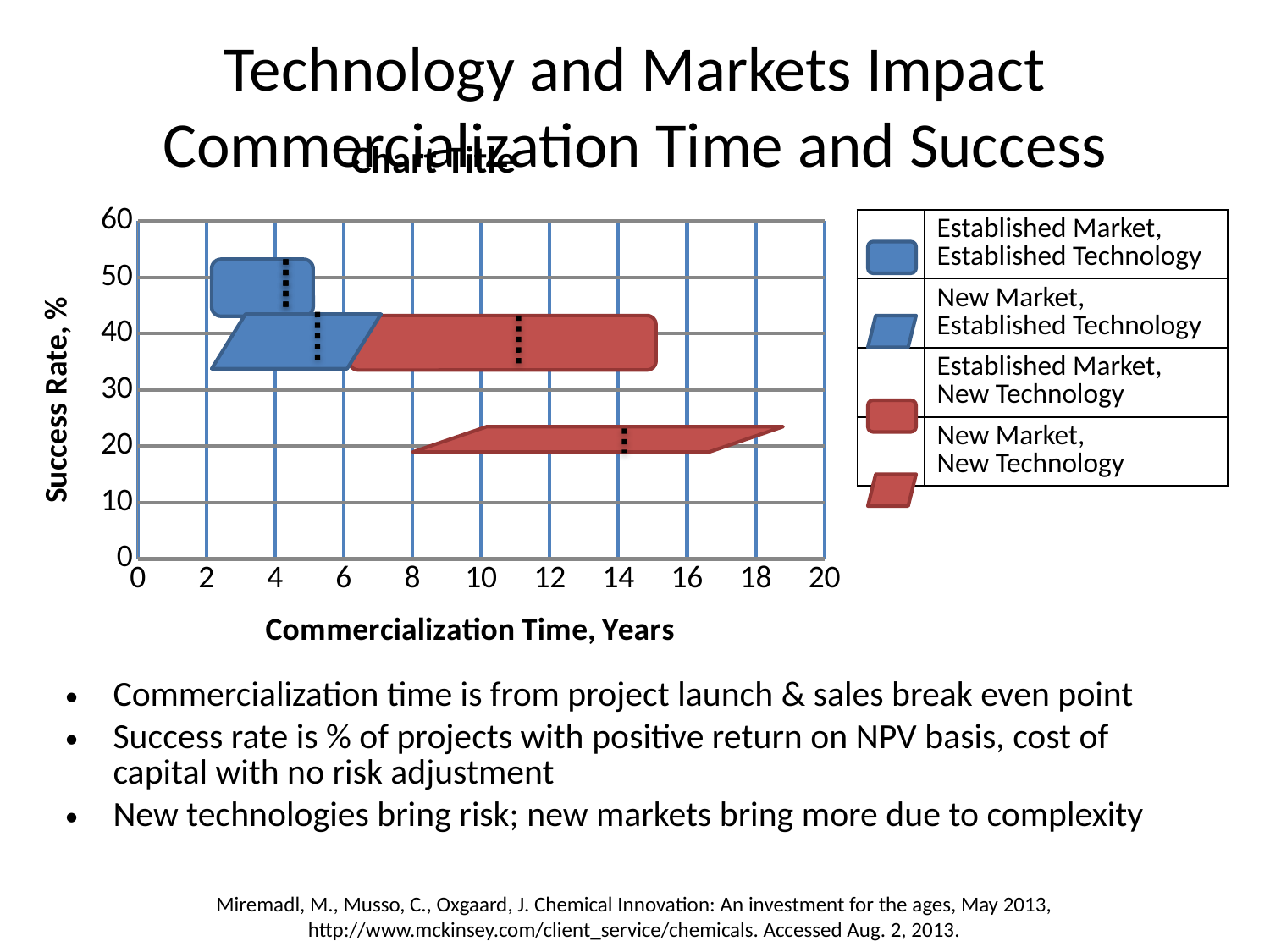
Is the success rate for New Market, New Technology greater or less than 30? less What is the maximum value shown on the vertical axis of the chart? 60 Is the commercialization time for Established Market, New Technology greater or less than 5 years? greater What is the title of the chart's vertical axis? Success Rate, % Which category extends to the longest commercialization time on the chart? New Market, New Technology How many entries does the chart legend list? 4 Which category has the shortest commercialization time on the chart? Established Market, Established Technology Is the success rate for Established Market, Established Technology greater or less than 40? greater Which category has the lowest success rate on the chart? New Market, New Technology Which has a higher success rate: Established Market, Established Technology or New Market, New Technology? Established Market, Established Technology Which category has the highest success rate on the chart? Established Market, Established Technology What is the title of the chart's horizontal axis? Commercialization Time, Years